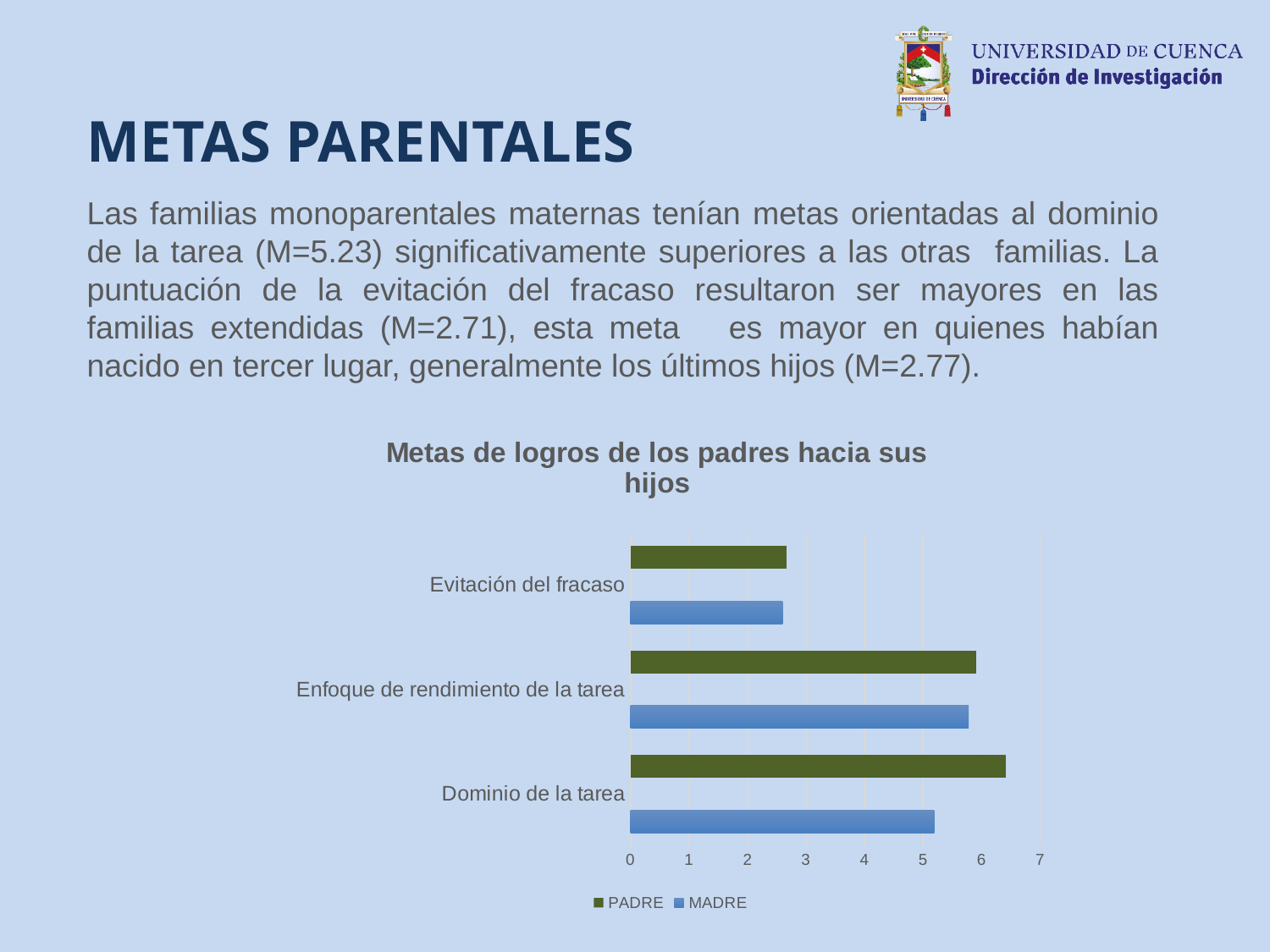
Is the PADRE value for Evitación del fracaso greater or less than 3? less How many categories are shown on the chart? 3 For the MADRE series, which category has the highest value? Enfoque de rendimiento de la tarea How many series does the chart legend list? 2 Which series is shown in green in the chart? PADRE For Dominio de la tarea, which series has the larger value, PADRE or MADRE? PADRE For the MADRE series, which category has the lowest value? Evitación del fracaso For the PADRE series, which category has the lowest value? Evitación del fracaso For the PADRE series, which category has the highest value? Dominio de la tarea Is the PADRE value for Dominio de la tarea greater or less than 6? greater What kind of chart is shown on the slide? bar chart What is the title of the chart? Metas de logros de los padres hacia sus hijos